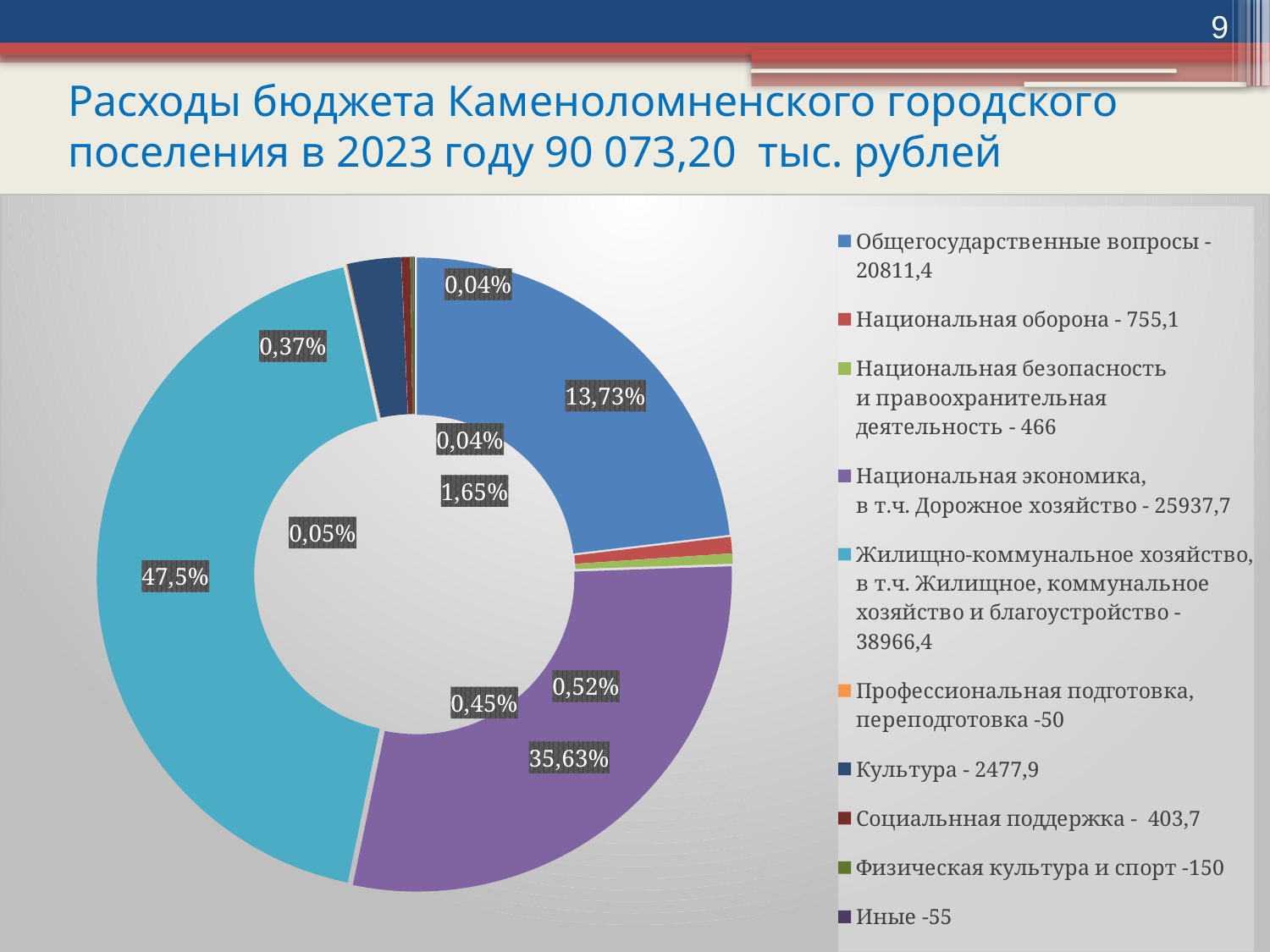
What value is given in the legend for Национальная оборона? 755,1 What share of the pie does Национальная экономика take? 35,63% Which category has the largest slice of the pie? Жилищно-коммунальное хозяйство What value is given in the legend for Иные? 55 What is the difference between the legend values for Жилищно-коммунальное хозяйство (38966,4) and Национальная экономика (25937,7)? 13028,7 Which is larger according to the legend values: Культура or Национальная оборона? Культура What is the total budget expenditure stated in the chart title? 90 073,20 тыс. рублей How many categories does the legend list? 10 What share of the pie does Жилищно-коммунальное хозяйство take? 47,5% What kind of chart is shown on the slide? Pie (doughnut) chart What value is given in the legend for Культура? 2477,9 What share of the pie does Общегосударственные вопросы take? 13,73%